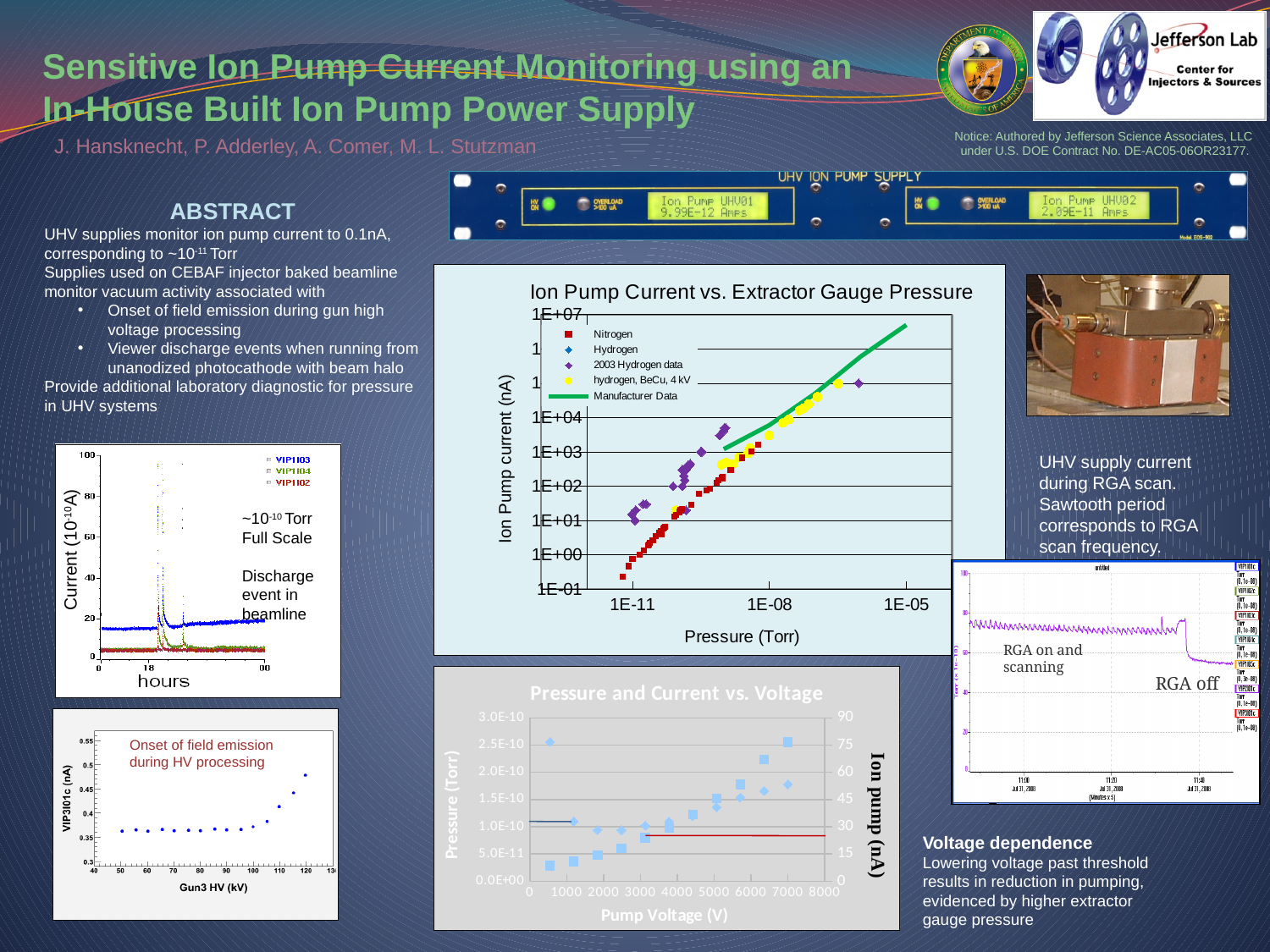
In the 'Pressure and Current vs. Voltage' chart, does the ion pump current generally rise or fall as pump voltage increases? rise In the 'Ion Pump Current vs. Extractor Gauge Pressure' chart, does ion pump current rise or fall as pressure increases along the x axis? rise In the 'Ion Pump Current vs. Extractor Gauge Pressure' chart, how many series does the legend list? 5 In the 'Pressure and Current vs. Voltage' chart, what is the label of the right-hand y axis? Ion pump (nA) In the 'Pressure and Current vs. Voltage' chart, what is the label of the x axis? Pump Voltage (V) What is the title of the large chart in the centre of the slide? Ion Pump Current vs. Extractor Gauge Pressure In the 'Ion Pump Current vs. Extractor Gauge Pressure' chart, what kind of chart is it? scatter chart In the chart at the left of the slide plotting current against hours, how many series does the legend list? 3 In the bottom-left chart of VIP3I01c (nA) versus Gun3 HV (kV), does the current rise or fall as the voltage increases past about 100 kV? rise